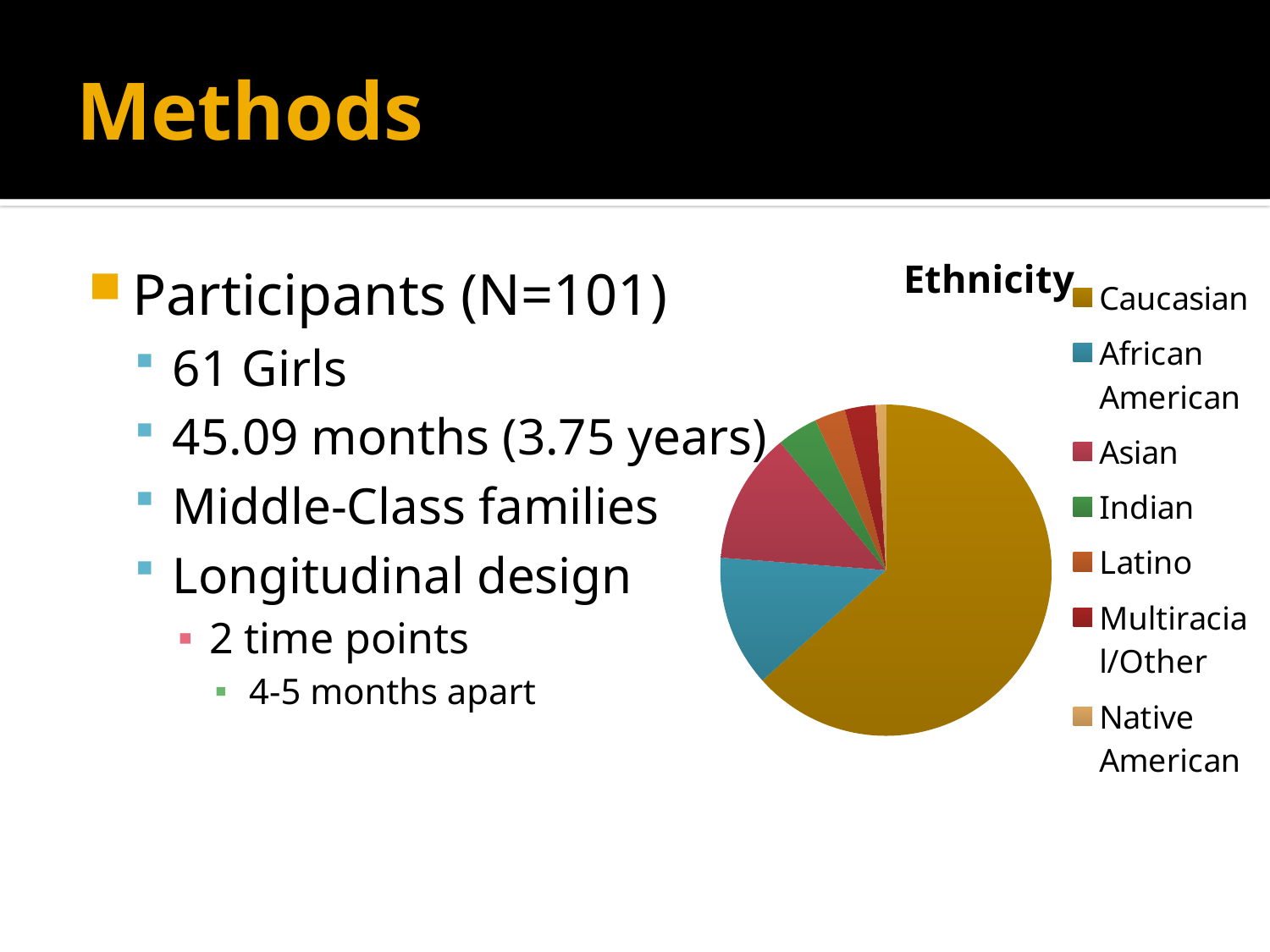
Which ethnicity category has the smallest slice of the pie? Native American How many ethnicity categories does the pie chart show? 7 Which colour represents the Caucasian category in the pie chart? gold Which slice is larger, Multiracial/Other or Native American? Multiracial/Other Which slice is larger, Asian or Indian? Asian Does the Caucasian slice make up more or less than half of the pie? more Which slice is larger, African American or Latino? African American What is the title of the chart? Ethnicity What kind of chart is shown on the slide? pie chart Which ethnicity category has the largest slice of the pie? Caucasian